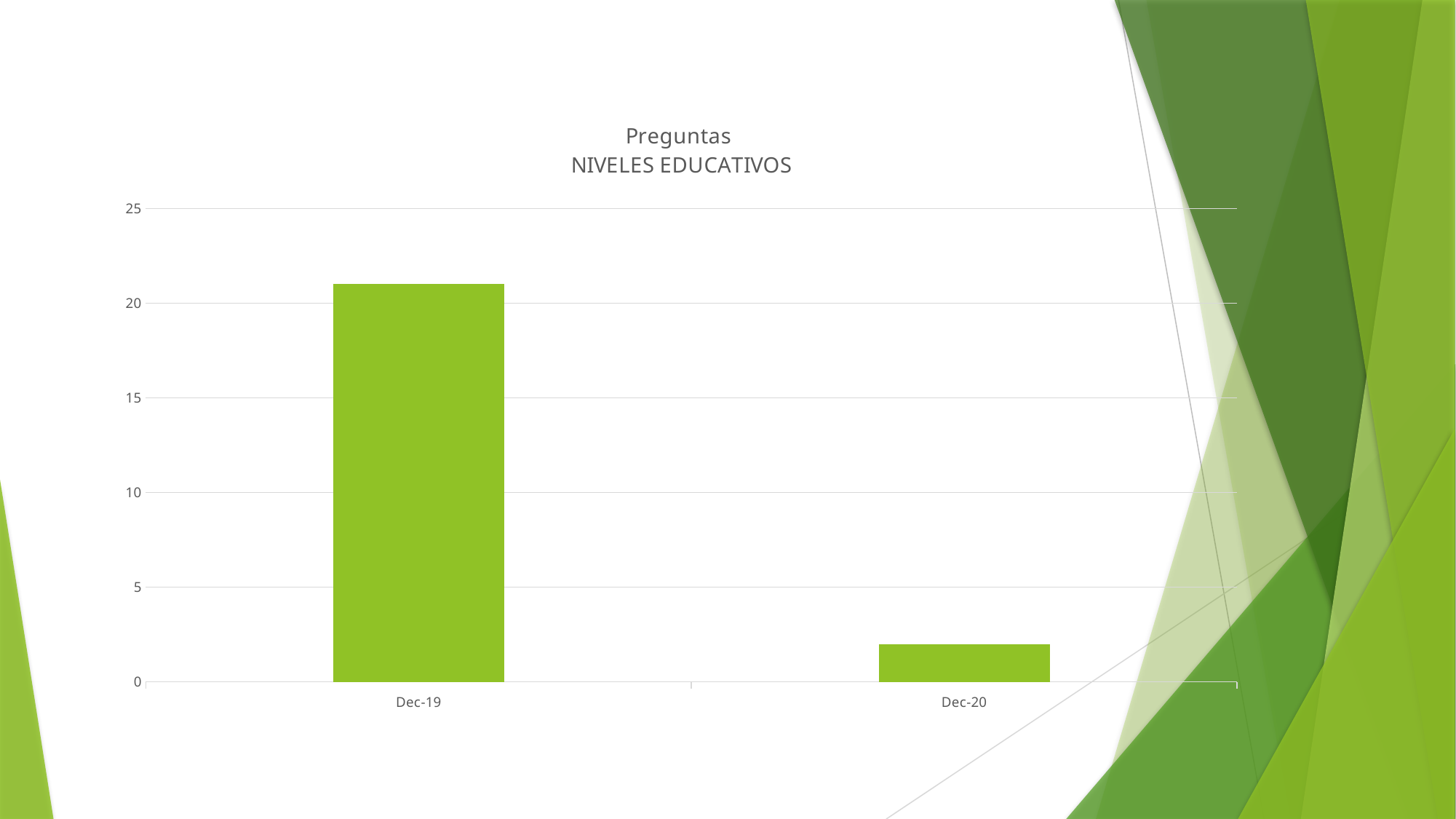
Do the values rise or fall from Dec-19 to Dec-20? fall What is the title of the chart? Preguntas NIVELES EDUCATIVOS Which category has the highest value? Dec-19 Which category has the lowest value? Dec-20 How many categories are shown on the x axis of the chart? 2 Which is larger, the value for Dec-19 or the value for Dec-20? Dec-19 What is the highest value shown on the vertical axis? 25 What kind of chart is shown on the slide? bar chart Is the value for Dec-20 greater or less than 5? less Is the value for Dec-20 greater or less than 10? less Is the value for Dec-19 greater or less than 20? greater